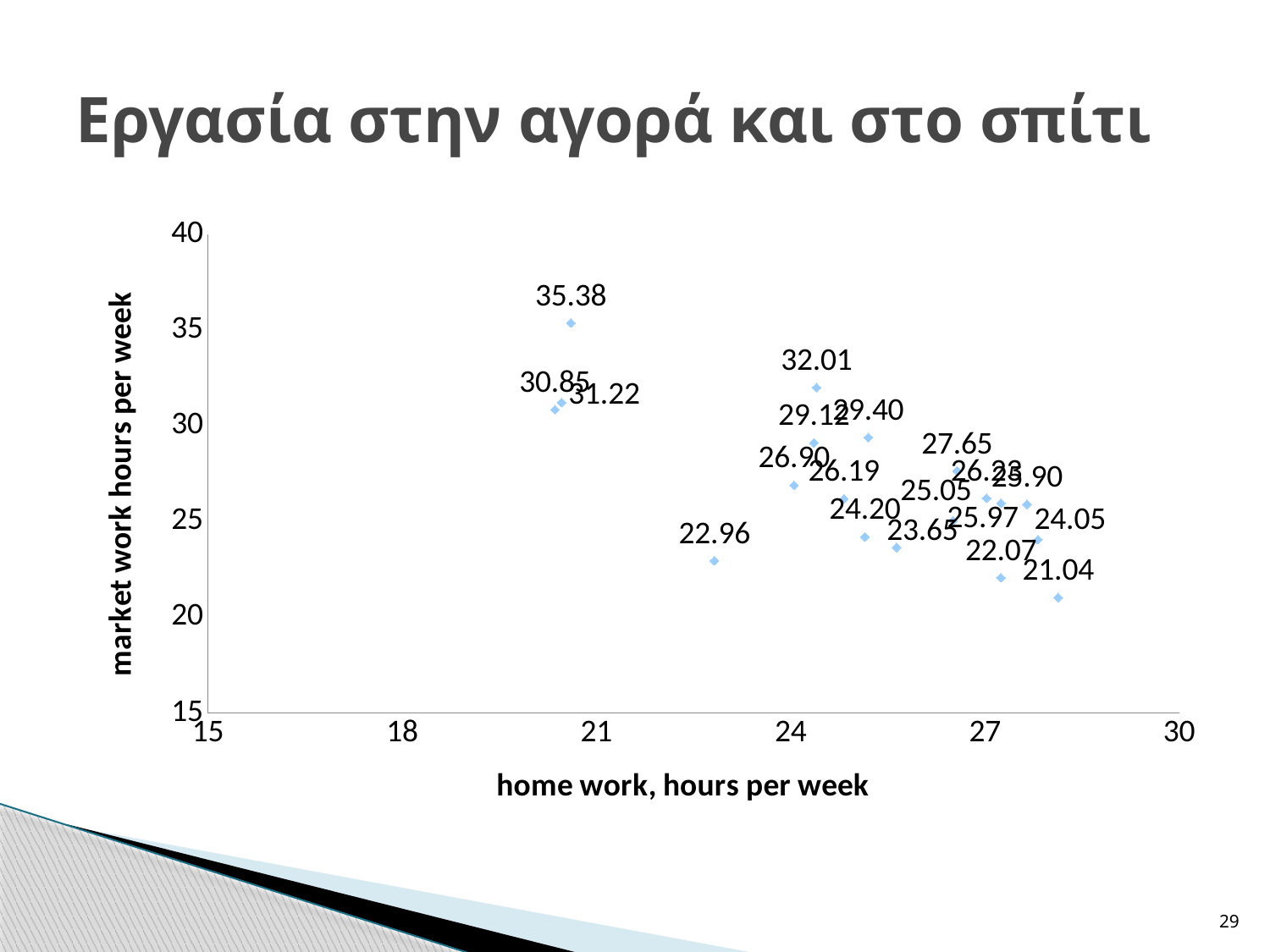
Is the home work value for the point labelled 22.96 greater or less than 24 hours per week? less What is the highest market work hours per week value labelled on the chart? 35.38 How many data points are plotted on the chart? 19 Which is larger, the labelled value 32.01 or the labelled value 29.40? 32.01 What is the title of the y axis? market work hours per week As home work hours per week increase along the x axis, do market work hours generally rise or fall? fall What kind of chart is shown on the slide? scatter chart Is the home work value for the point labelled 21.04 greater or less than 27 hours per week? greater What is the lowest market work hours per week value labelled on the chart? 21.04 What is the title of the x axis? home work, hours per week What is the difference between the highest and lowest labelled market work values (35.38 and 21.04)? 14.34 How many labelled points have a market work value above 30 hours per week? 4